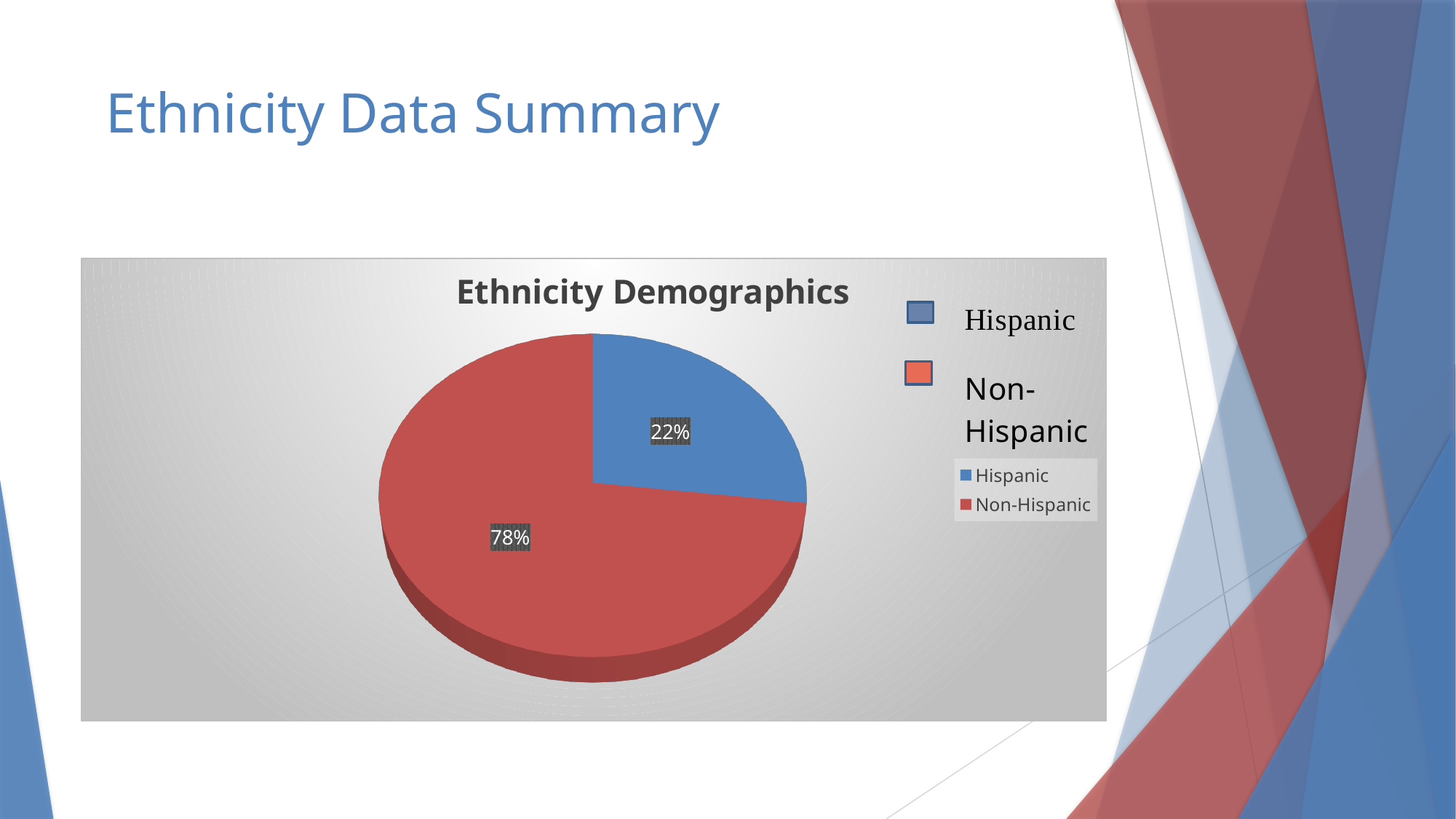
What share of the pie does the Non-Hispanic slice represent? 78% What is the total of the two slice percentages shown? 100% Which category has the largest slice of the pie? Non-Hispanic What kind of chart is shown on the slide? Pie chart What is the difference in percentage points between the Non-Hispanic and Hispanic slices? 56 Which category has the smallest slice of the pie? Hispanic Which is larger, the Hispanic slice or the Non-Hispanic slice? Non-Hispanic What is the title of the chart? Ethnicity Demographics What colour is the Non-Hispanic slice? Red How many slices does the pie chart have? 2 What share of the pie does the Hispanic slice represent? 22%